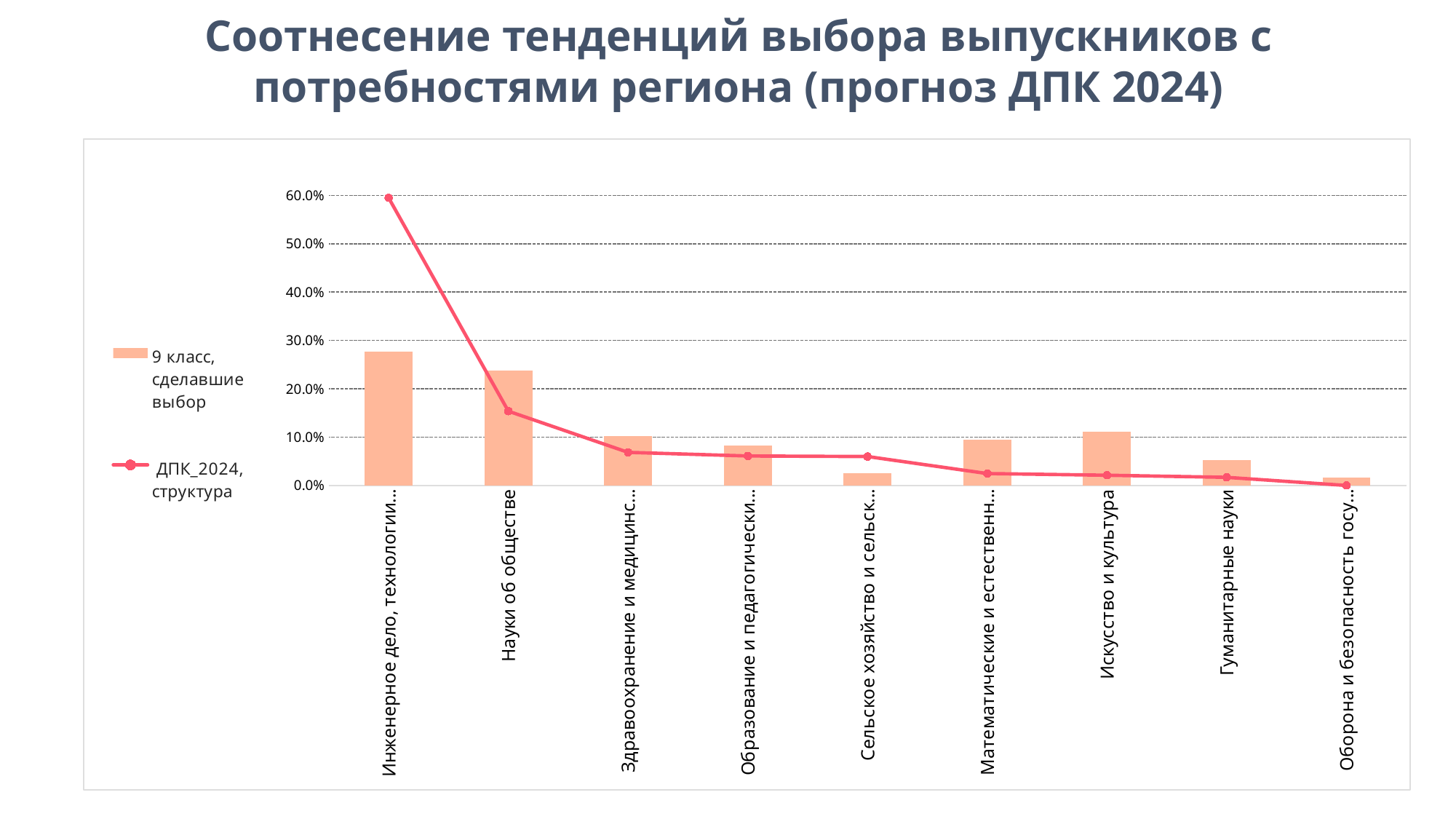
How many series does the legend list? 2 What are the two legend entries of the chart? 9 класс, сделавшие выбор; ДПК_2024, структура Is the 9 класс, сделавшие выбор value for Гуманитарные науки greater or less than 10.0%? less Which category has the highest value for the ДПК_2024, структура line? Инженерное дело, технологии... For Искусство и культура, which is larger: the 9 класс, сделавшие выбор bar or the ДПК_2024, структура point? 9 класс, сделавшие выбор What kind of chart is shown on the slide? A combined bar and line chart Is the 9 класс, сделавшие выбор value for Науки об обществе greater or less than 20.0%? greater Is the ДПК_2024, структура value for Науки об обществе greater or less than 20.0%? less How many categories are shown on the x axis? 9 Does the ДПК_2024, структура line generally rise or fall from left to right along the x axis? fall Which category has the tallest bar for 9 класс, сделавшие выбор? Инженерное дело, технологии...